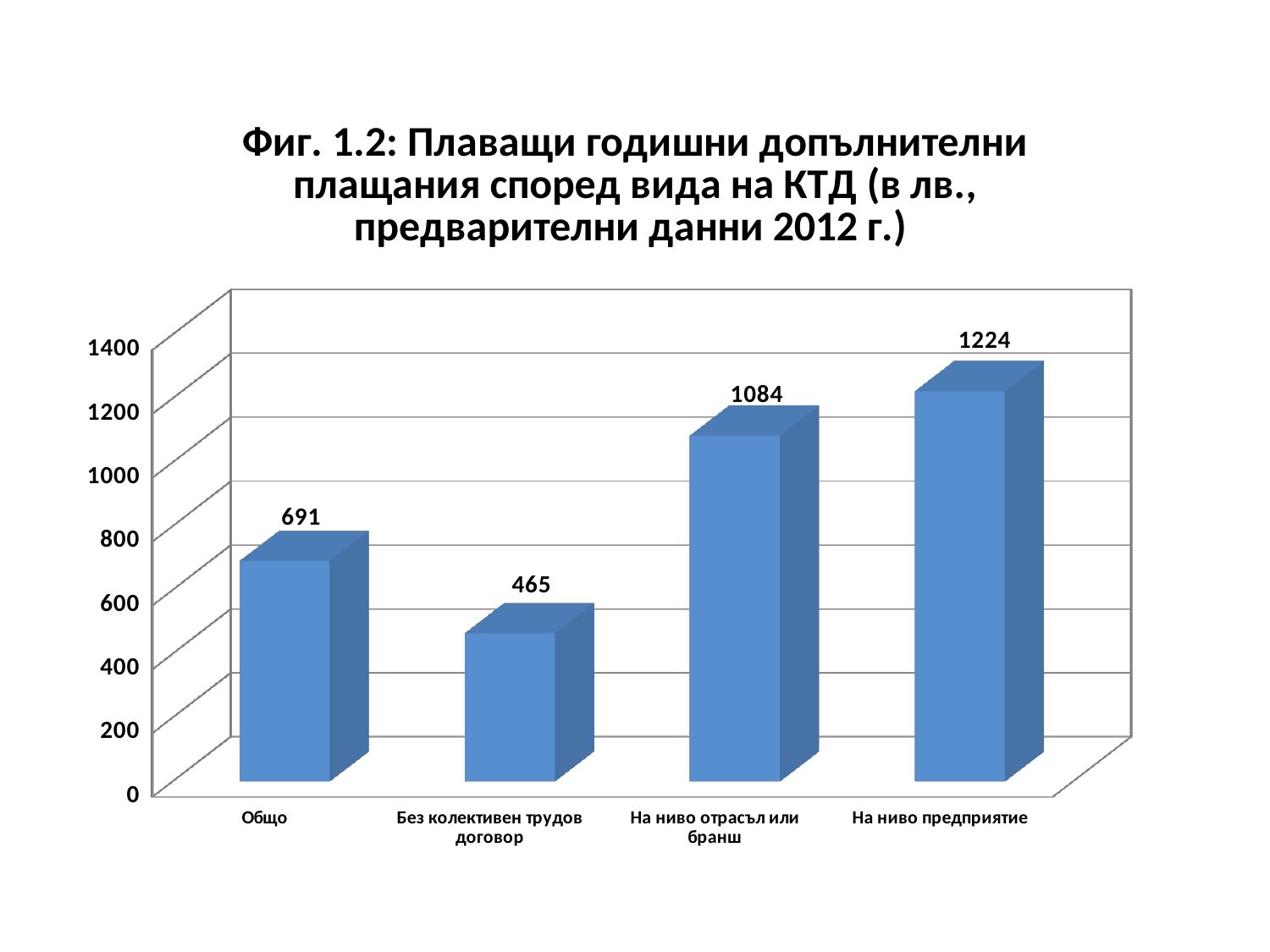
What is the value for Без колективен трудов договор? 465 How many categories are shown on the chart? 4 Which category has the lowest value? Без колективен трудов договор Is the value for Без колективен трудов договор greater or less than 600? less What is the value for На ниво предприятие? 1224 What is the difference between the values for На ниво предприятие and На ниво отрасъл или бранш? 140 What is the difference between the values for Общо and Без колективен трудов договор? 226 What is the value for На ниво отрасъл или бранш? 1084 What is the value for Общо? 691 Which is larger, the value for Общо or the value for На ниво отрасъл или бранш? На ниво отрасъл или бранш What kind of chart is shown on the slide? bar chart Which category has the highest value? На ниво предприятие